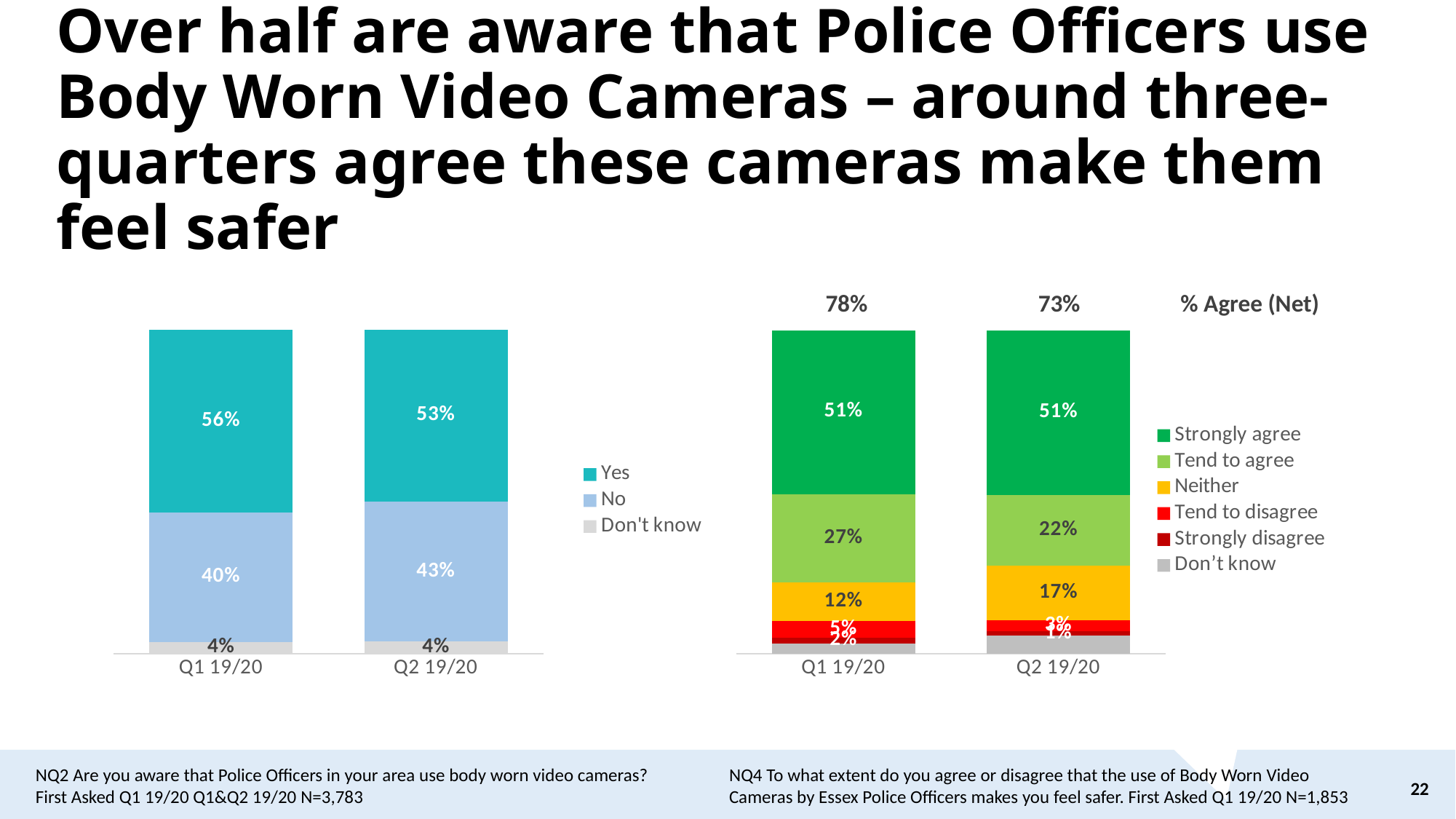
In the left chart (awareness of body worn video cameras), how many series does the legend list? 3 In the right chart (cameras make you feel safer), how many series does the legend list? 6 In the left chart (awareness of body worn video cameras), what percentage answered Yes in Q1 19/20? 56% In the left chart (awareness of body worn video cameras), what percentage answered Don't know in Q1 19/20? 4% In the right chart (cameras make you feel safer), which quarter has the higher Tend to agree share, Q1 19/20 or Q2 19/20? Q1 19/20 In the left chart (awareness of body worn video cameras), by how many percentage points did the Yes share fall from Q1 19/20 to Q2 19/20? 3 percentage points In the left chart (awareness of body worn video cameras), what percentage answered No in Q2 19/20? 43% In the right chart (cameras make you feel safer), what percentage strongly agreed in Q2 19/20? 51% In the right chart (cameras make you feel safer), what is the % Agree (Net) figure for Q1 19/20? 78% In the right chart (cameras make you feel safer), what is the difference between the Neither shares in Q2 19/20 and Q1 19/20? 5 percentage points What type of chart is used on the left of the slide? Stacked bar chart In the right chart (cameras make you feel safer), what percentage answered Neither in Q2 19/20? 17%